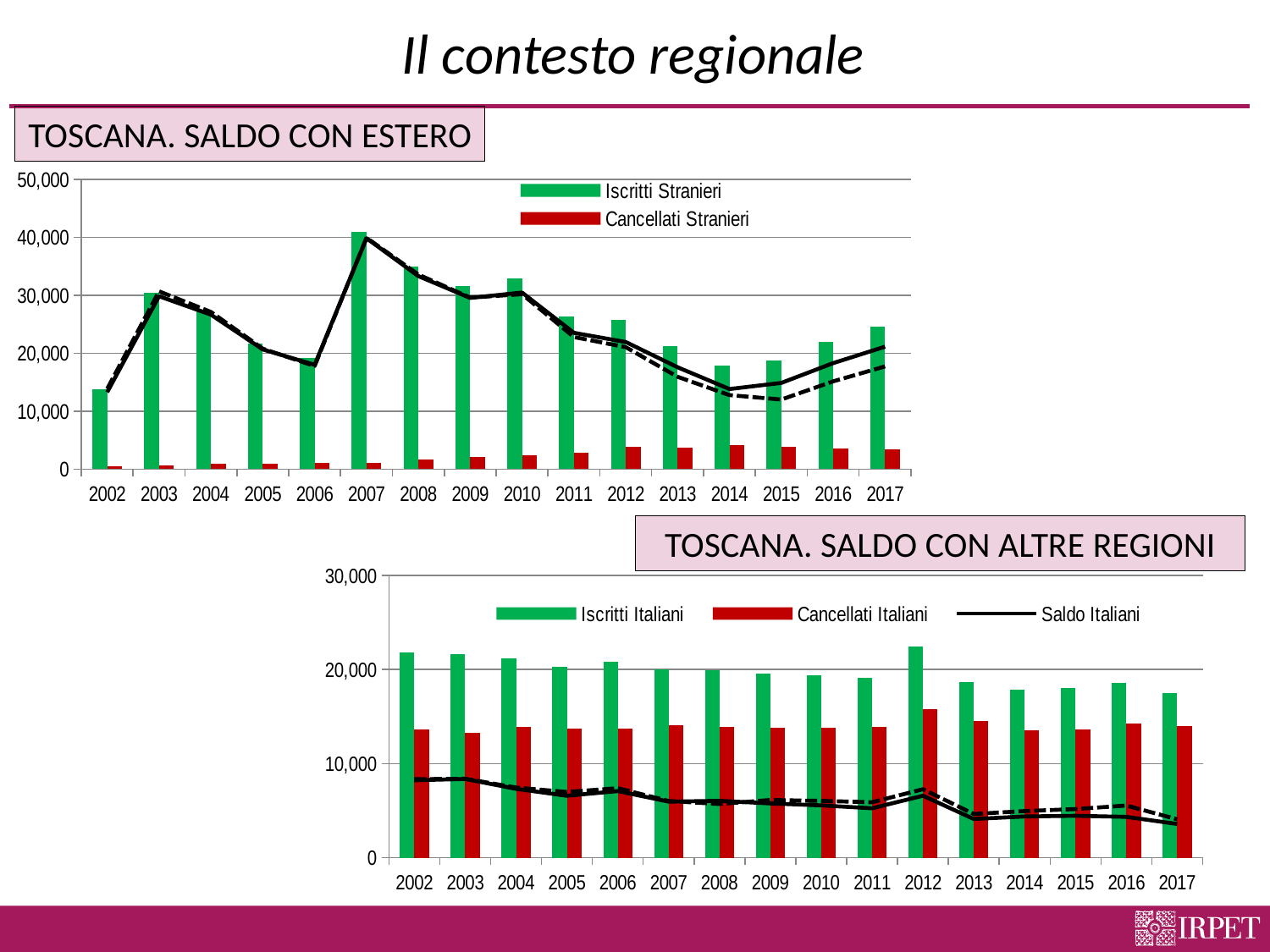
In the chart titled 'TOSCANA. SALDO CON ALTRE REGIONI', does the Saldo Italiani line generally rise or fall from 2002 to 2017? fall What kind of chart is the chart titled 'TOSCANA. SALDO CON ALTRE REGIONI'? Bar chart with lines How many years are shown on the x axis of the chart titled 'TOSCANA. SALDO CON ESTERO'? 16 In the chart titled 'TOSCANA. SALDO CON ALTRE REGIONI', which year has the highest value for Cancellati Italiani? 2012 In the chart titled 'TOSCANA. SALDO CON ALTRE REGIONI', is the value for Iscritti Italiani in 2002 greater or less than 20,000? greater In the chart titled 'TOSCANA. SALDO CON ESTERO', which year has the lowest value for Iscritti Stranieri? 2002 In the chart titled 'TOSCANA. SALDO CON ESTERO', is the value for Cancellati Stranieri in 2014 greater or less than 10,000? less In the chart titled 'TOSCANA. SALDO CON ESTERO', which is larger in 2010: Iscritti Stranieri or Cancellati Stranieri? Iscritti Stranieri How many series does the legend list in the chart titled 'TOSCANA. SALDO CON ALTRE REGIONI'? 3 In the chart titled 'TOSCANA. SALDO CON ESTERO', which year has the highest value for Iscritti Stranieri? 2007 In the chart titled 'TOSCANA. SALDO CON ESTERO', is the value for Iscritti Stranieri in 2007 greater or less than 30,000? greater